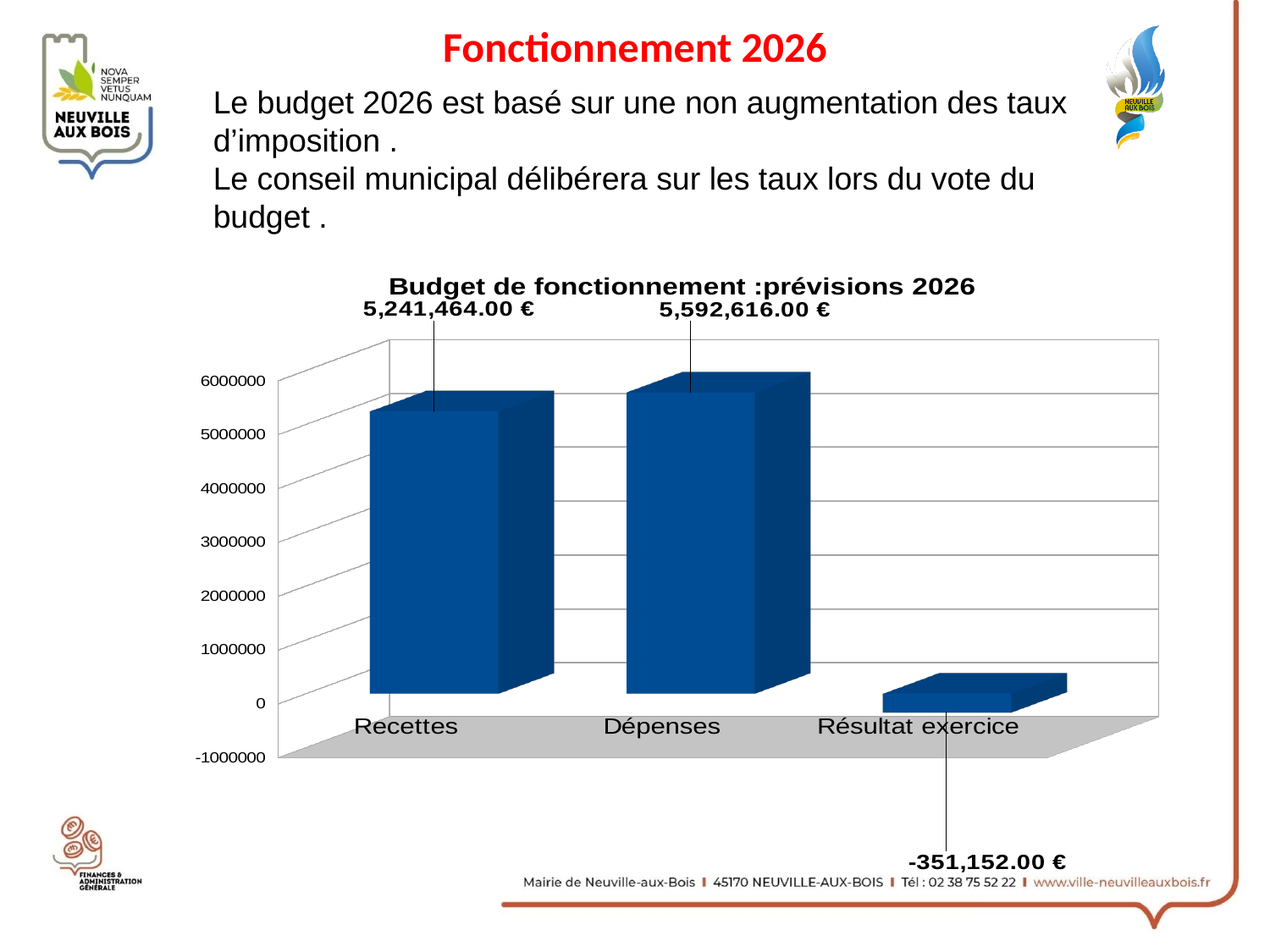
Is the value for Résultat exercice greater or less than 0? less Which category has the highest value? Dépenses Which is larger, Recettes or Dépenses? Dépenses Which category has the lowest value? Résultat exercice Is the value for Recettes greater or less than 5000000? greater What is the value for Dépenses? 5,592,616.00 € What is the value for Résultat exercice? -351,152.00 € How many categories are shown on the chart? 3 What is the title of the chart? Budget de fonctionnement :prévisions 2026 What is the difference between Dépenses and Recettes? 351,152.00 € What is the value for Recettes? 5,241,464.00 € What kind of chart is shown? bar chart